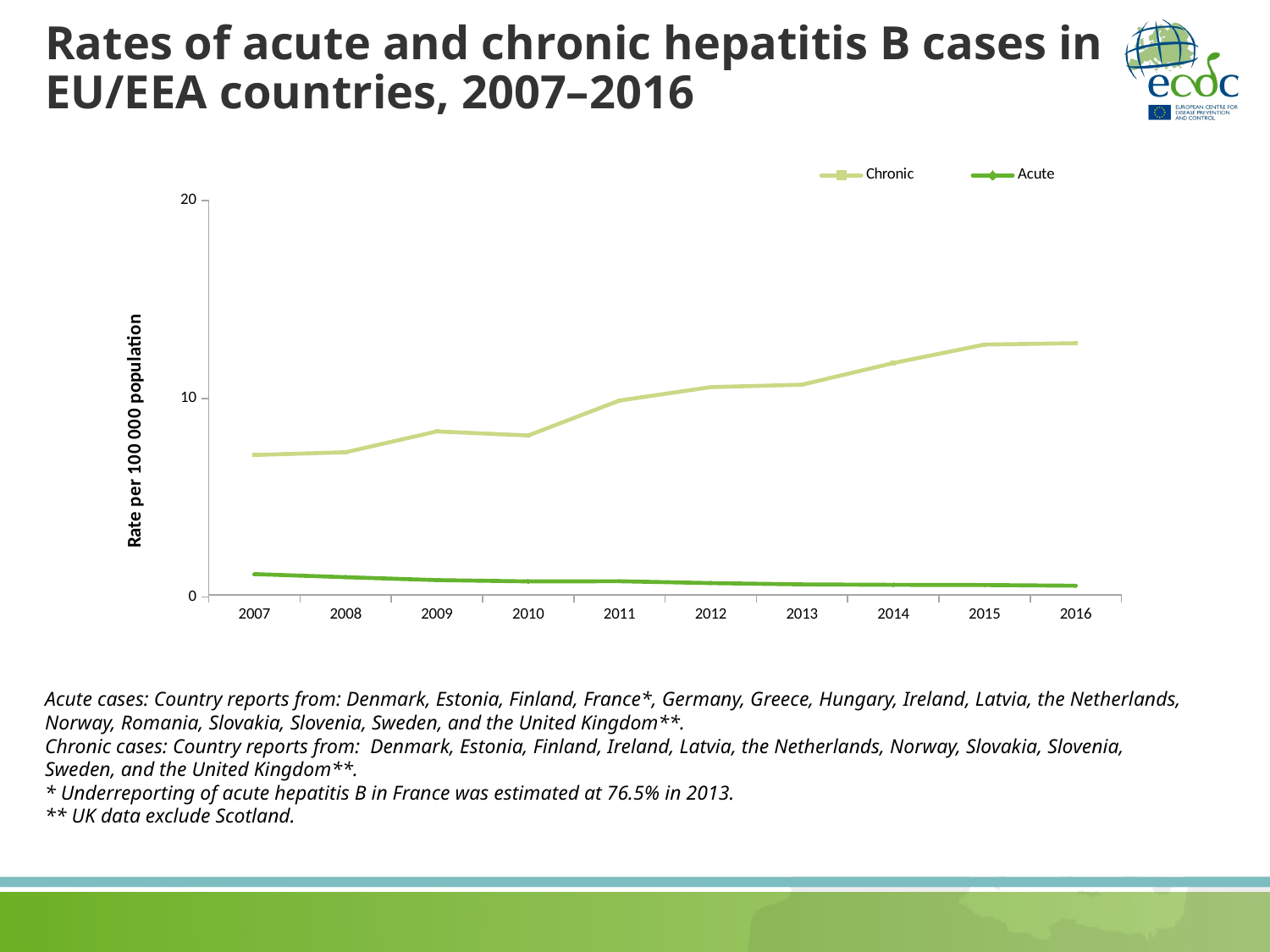
What type of chart is shown on the slide? line chart Is the Acute value for 2010 greater or less than 10? less Which series has the higher value in 2016, Chronic or Acute? Chronic How many years are shown along the x axis? 10 Does the Chronic series rise or fall from 2007 to 2016? rise How many series does the legend list? 2 In which year is the Chronic series at its lowest? 2007 What are the two series named in the legend? Chronic and Acute Is the Chronic value for 2016 greater or less than 10? greater Does the Acute series rise or fall from 2007 to 2016? fall Is the Chronic value for 2007 greater or less than 10? less What is the label of the y axis? Rate per 100 000 population